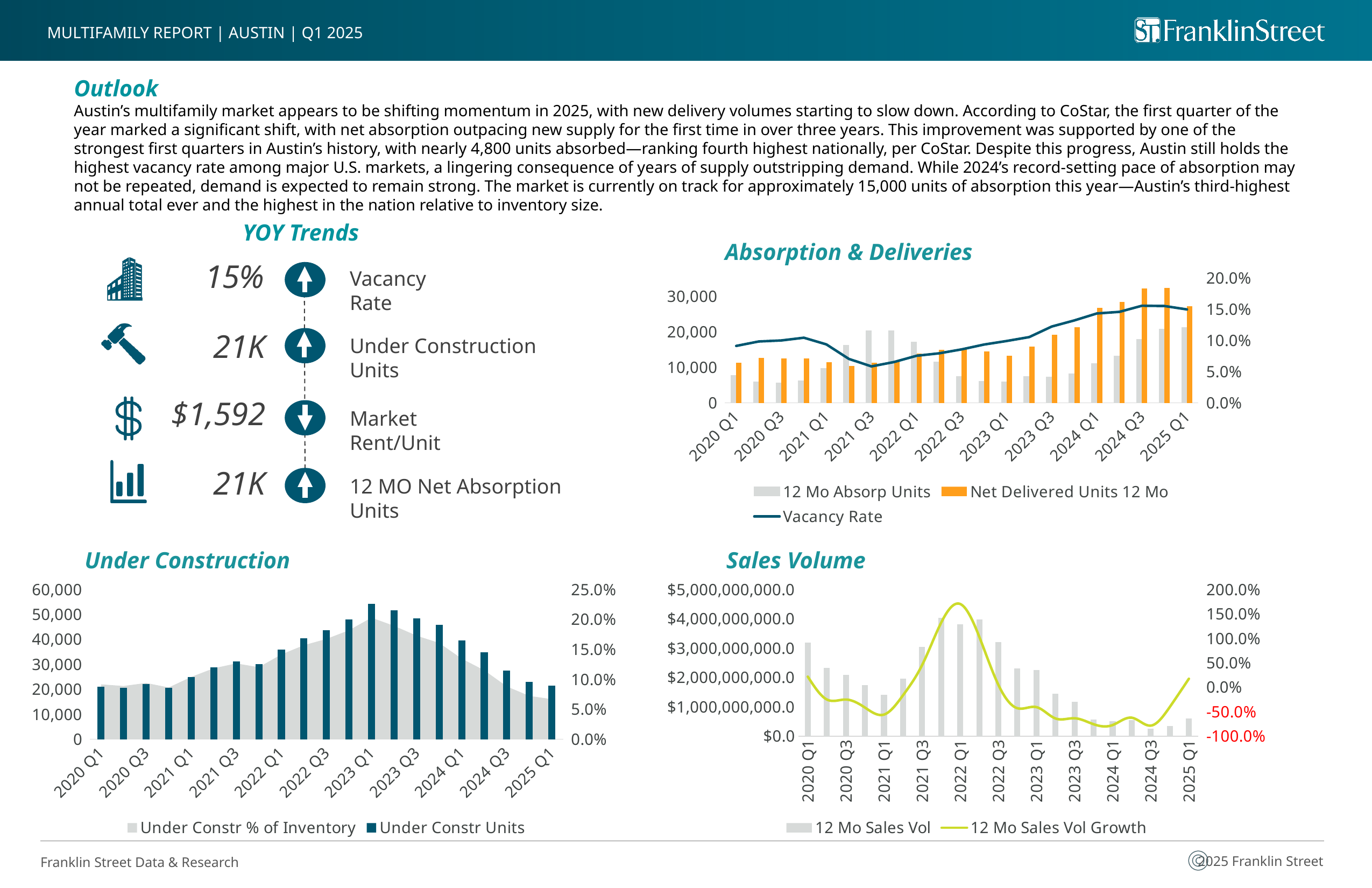
In the Under Construction chart, how many quarters are shown on the x axis? 21 In the Sales Volume chart, which is larger, the 12 Mo Sales Vol for 2020 Q1 or for 2025 Q1? 2020 Q1 In the Sales Volume chart, is the 12 Mo Sales Vol Growth value for 2022 Q1 greater or less than 150.0%? greater In the Absorption & Deliveries chart, is the 12 Mo Absorp Units value for 2020 Q3 greater or less than 10,000? less In the Absorption & Deliveries chart, which quarter has the lowest Vacancy Rate? 2021 Q3 In the Under Construction chart, do Under Constr Units rise or fall from 2023 Q1 to 2025 Q1? fall In the Under Construction chart, is the Under Constr Units value for 2023 Q1 greater or less than 50,000? greater In the Sales Volume chart, which quarter has the lowest 12 Mo Sales Vol? 2024 Q3 In the Absorption & Deliveries chart, how many series does the legend list? 3 In the Under Construction chart, which quarter has the highest Under Constr Units? 2023 Q1